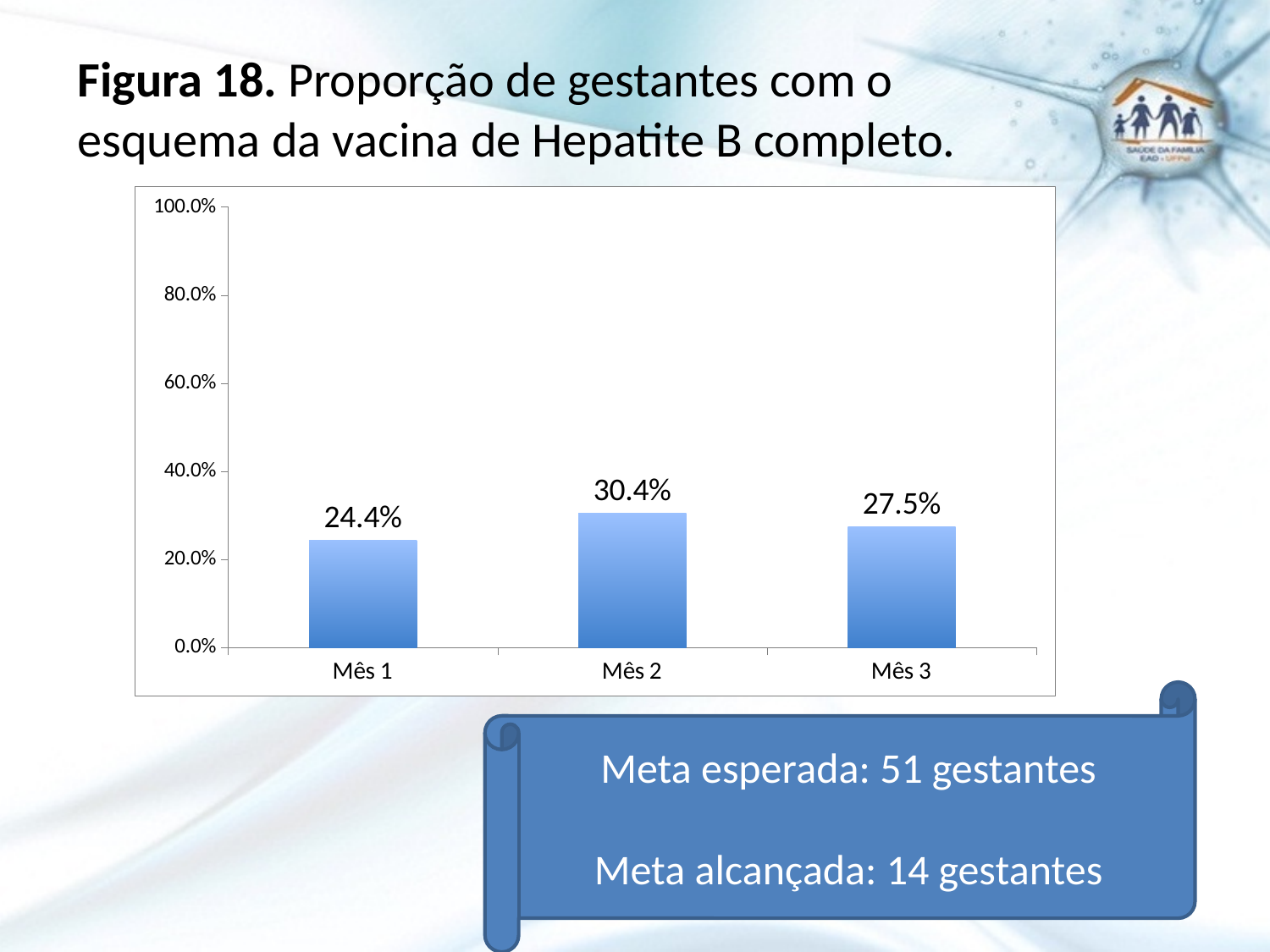
Is the value for Mês 2 greater or less than 40.0%? less What kind of chart is shown on the slide? bar chart What is the value for Mês 1? 24.4% What is the value for Mês 3? 27.5% How many months are shown on the x axis? 3 Which month has the lowest value? Mês 1 What is the value for Mês 2? 30.4% Which is larger, the value for Mês 3 or the value for Mês 1? Mês 3 Which month has the highest value? Mês 2 What is the difference between the values for Mês 2 and Mês 3? 2.9% What is the difference between the values for Mês 2 and Mês 1? 6.0% What is the figure number given in the slide title? Figura 18